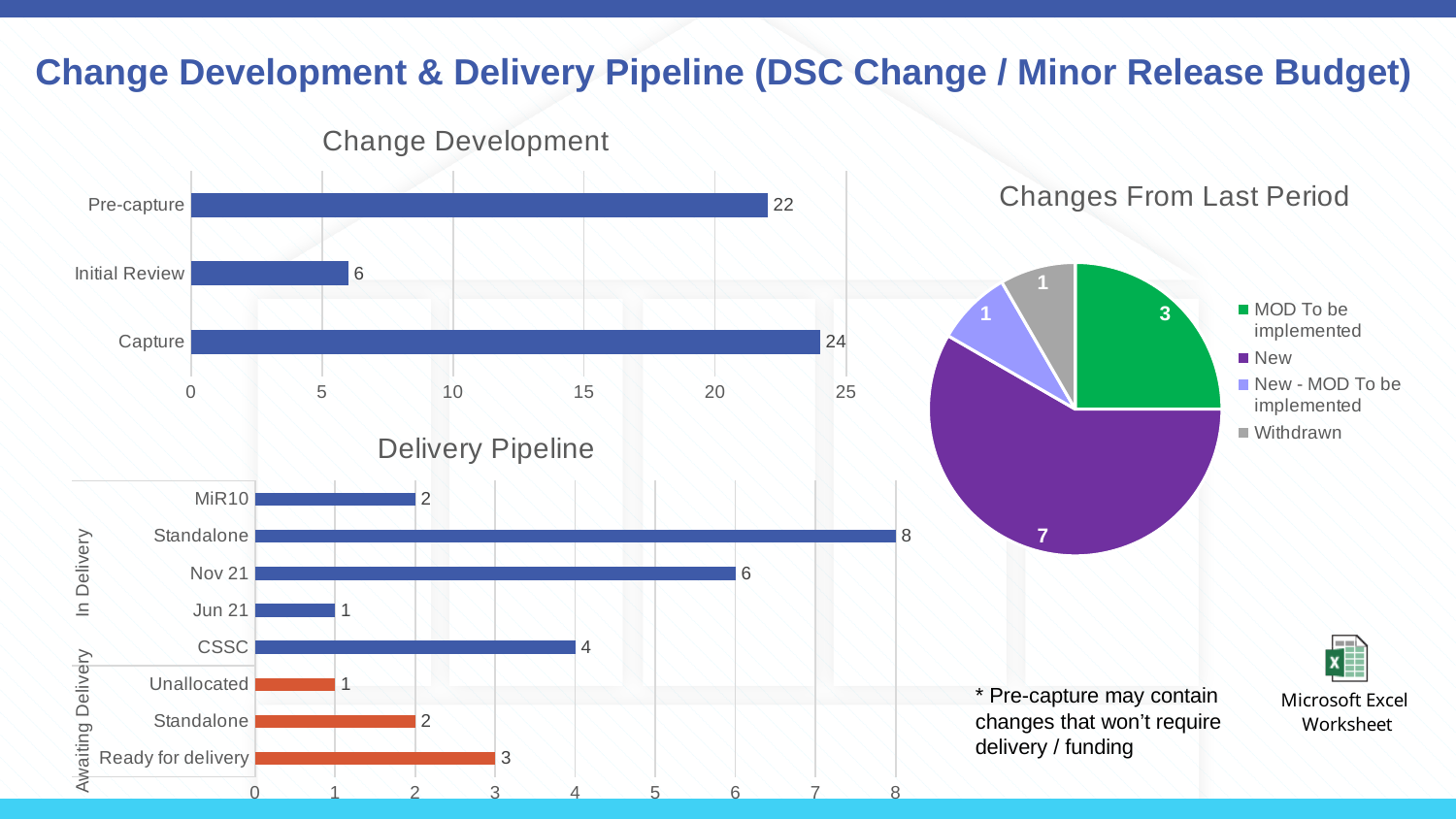
In the Change Development chart, what is the value for Pre-capture? 22 In the Changes From Last Period pie chart, what is the value for New? 7 In the Change Development chart, how many categories are shown? 3 In the Changes From Last Period pie chart, what share of the total does MOD To be implemented represent? 25% In the Delivery Pipeline chart, what is the value for Ready for delivery under Awaiting Delivery? 3 In the Change Development chart, which category has the highest value? Capture In the Delivery Pipeline chart, which is larger: CSSC or MiR10? CSSC In the Delivery Pipeline chart, how many categories are shown in total? 8 In the Delivery Pipeline chart, which category has the highest value? Standalone (In Delivery) In the Change Development chart, what is the difference between Capture and Initial Review? 18 What kind of chart is Changes From Last Period? Pie chart In the Delivery Pipeline chart, what is the value for Nov 21? 6